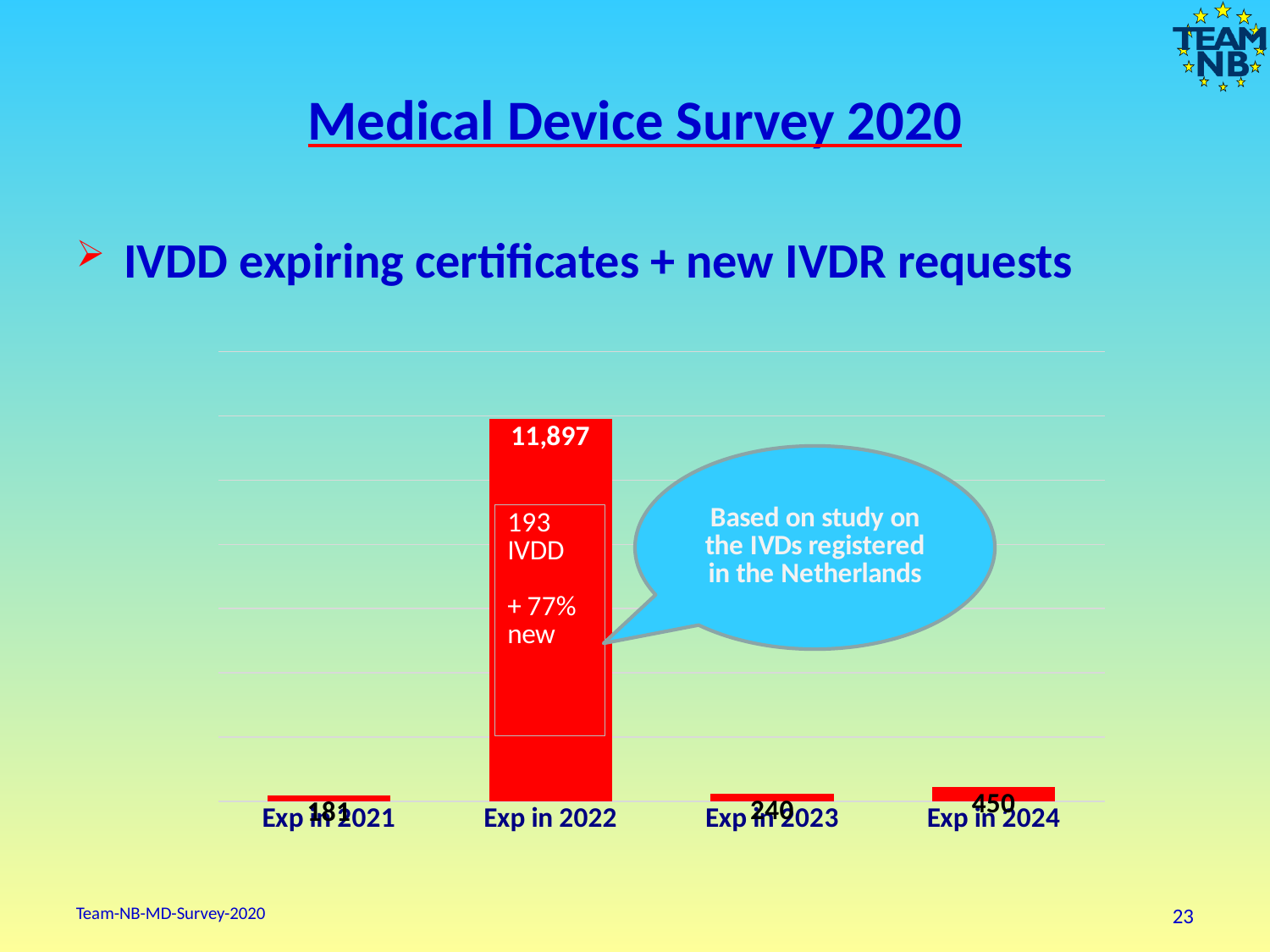
What is the value for Exp in 2021? 181 What is the difference between the values for Exp in 2024 and Exp in 2023? 210 How many categories are shown on the x axis? 4 Which is larger, the value for Exp in 2024 or the value for Exp in 2023? Exp in 2024 What is the value for Exp in 2024? 450 What is the value for Exp in 2022? 11,897 What kind of chart is shown on the slide? Bar chart Which category has the highest value? Exp in 2022 What colour are the bars in the chart? Red What is the value for Exp in 2023? 240 What is the difference between the values for Exp in 2022 and Exp in 2021? 11,716 Which category has the lowest value? Exp in 2021